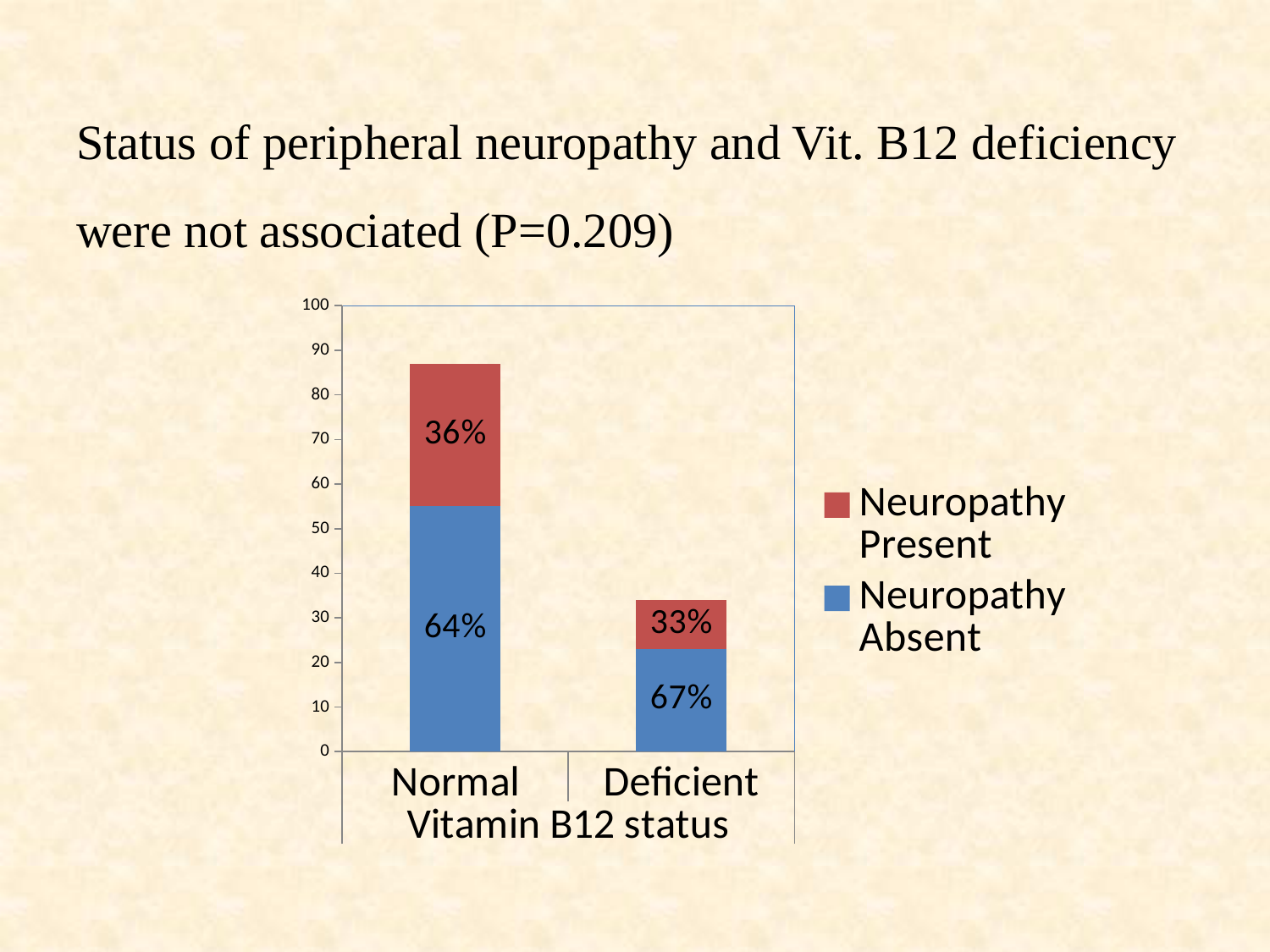
What kind of chart is shown on the slide? stacked bar chart Is the total height of the Normal stacked bar greater or less than 80? greater Which colour represents Neuropathy Absent in the chart legend? blue Is the total height of the Deficient stacked bar greater or less than 40? less How many categories are shown on the x axis of the chart? 2 What percentage label is shown on the Neuropathy Absent segment of the Normal bar? 64% How many series does the chart legend list? 2 Which category has the taller stacked bar, Normal or Deficient? Normal What is the title of the x axis of the chart? Vitamin B12 status What percentage label is shown on the Neuropathy Present segment of the Deficient bar? 33% What percentage label is shown on the Neuropathy Present segment of the Normal bar? 36% What percentage label is shown on the Neuropathy Absent segment of the Deficient bar? 67%